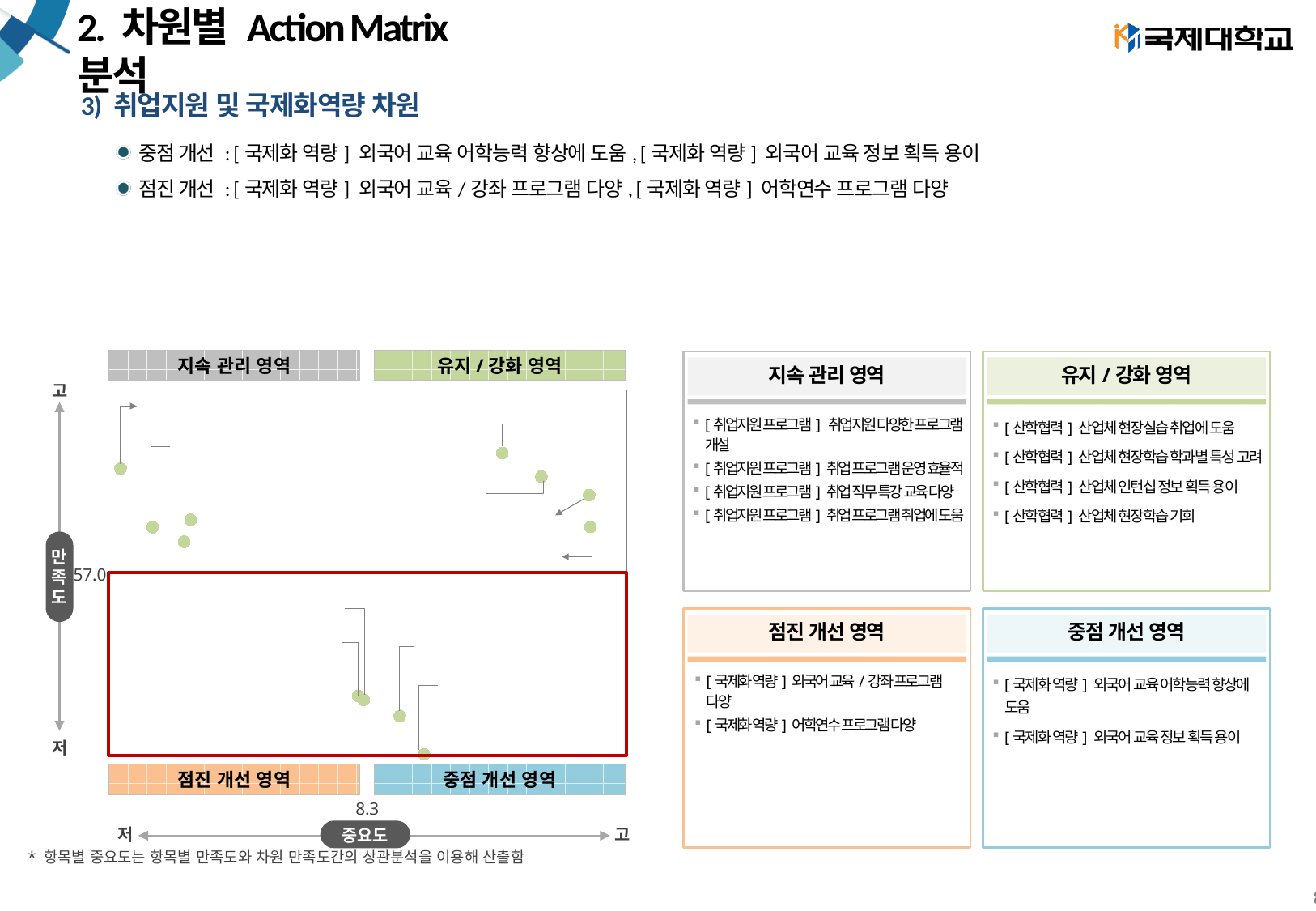
What value marks the vertical dividing line on the 중요도 axis of the action matrix? 8.3 Is the 중요도 value for [국제화역량] 외국어 교육 정보 획득 용이 greater or less than 8.3? greater How many points are plotted in the action matrix in total? 12 How many items fall in the 점진 개선 영역 quadrant of the action matrix? 2 Is the 만족도 value for [산학협력] 산업체 현장학습 기회 greater or less than 57.0? greater How many items fall in the 중점 개선 영역 quadrant of the action matrix? 2 What is the label of the vertical axis of the action matrix? 만족도 What value marks the horizontal dividing line on the 만족도 axis of the action matrix? 57.0 Is the 만족도 value for [국제화역량] 어학연수 프로그램 다양 greater or less than 57.0? less What is the label of the horizontal axis of the action matrix? 중요도 What kind of chart is shown on the left of the slide? scatter chart